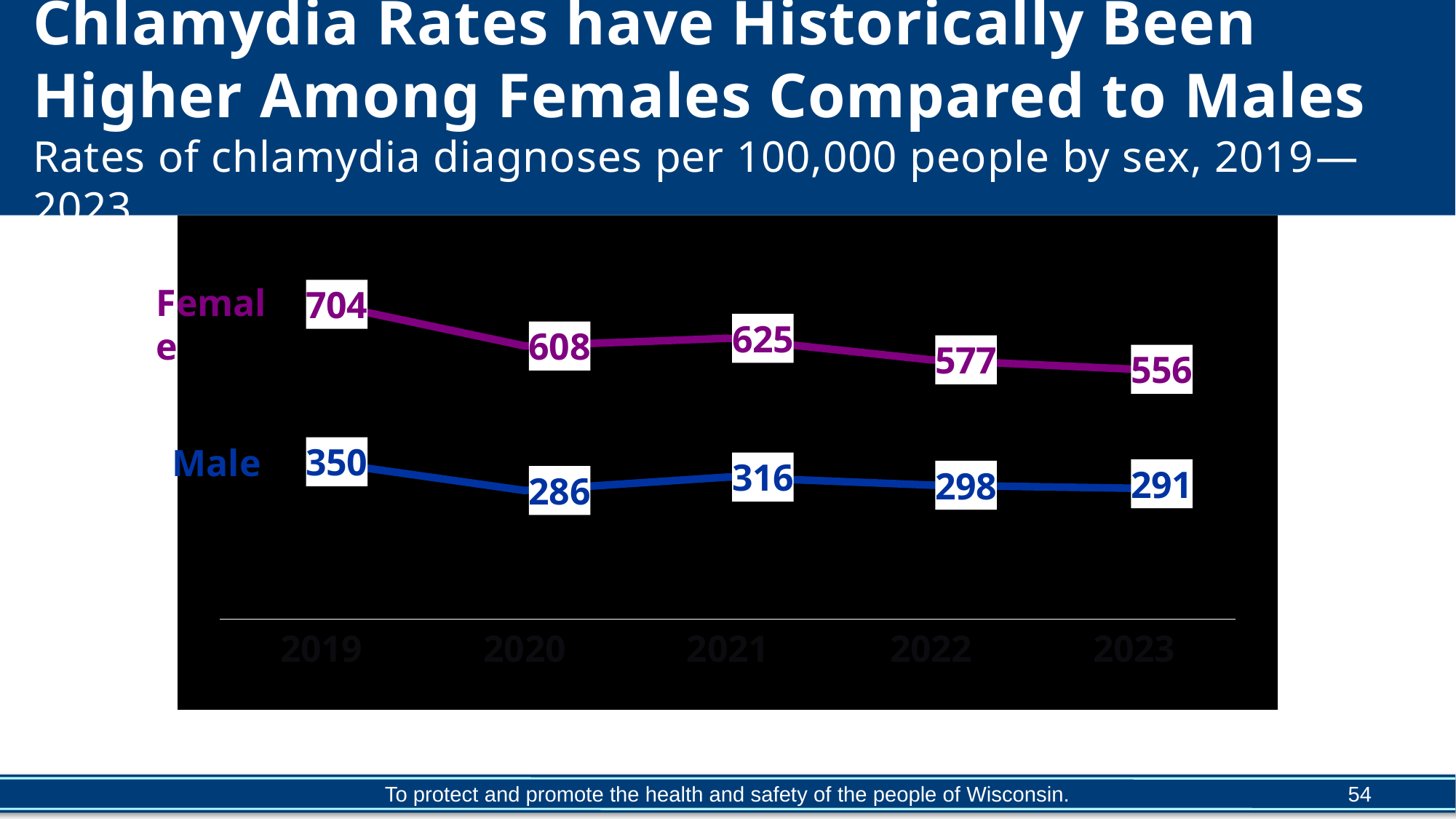
What was the chlamydia rate for males in 2021? 316 Did the male chlamydia rate rise or fall from 2019 to 2023 overall? Fall What kind of chart is shown on the slide? Line chart By how much did the female chlamydia rate fall from 2019 to 2020? 96 What was the chlamydia rate for females in 2023? 556 What is the difference between the female and male chlamydia rates in 2022? 279 Which was higher in 2021, the female rate or the male rate? Female What was the chlamydia rate for females in 2019? 704 How many series are plotted on the chart? 2 In which year was the female chlamydia rate highest? 2019 How many years are shown on the x axis? 5 In which year was the male chlamydia rate lowest? 2020